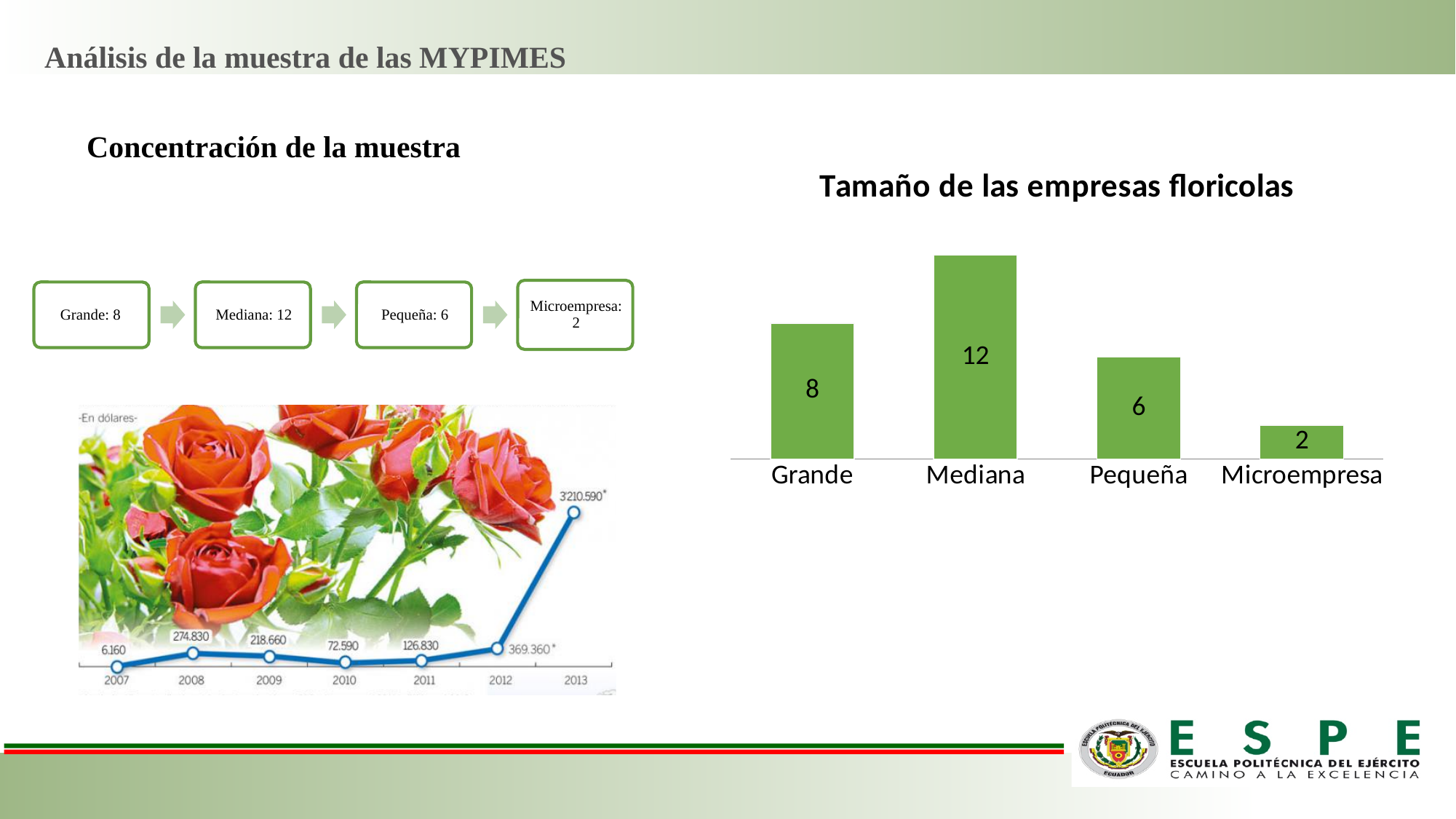
In the bar chart 'Tamaño de las empresas floricolas', what is the value for Microempresa? 2 In the line chart on the left of the slide, what is the value for 2007? 6.160 In the line chart on the left of the slide, which year has the highest value? 2013 In the bar chart 'Tamaño de las empresas floricolas', what is the difference between the values for Grande and Pequeña? 2 In the bar chart 'Tamaño de las empresas floricolas', which category has the highest value? Mediana How many categories are shown in the bar chart 'Tamaño de las empresas floricolas'? 4 What kind of chart is 'Tamaño de las empresas floricolas'? bar chart In the bar chart 'Tamaño de las empresas floricolas', which category has the lowest value? Microempresa In the bar chart 'Tamaño de las empresas floricolas', what is the value for Mediana? 12 In the bar chart 'Tamaño de las empresas floricolas', which is larger, the value for Grande or the value for Pequeña? Grande In the line chart on the left of the slide, what is the value for 2013? 3210.590 How many years are plotted in the line chart on the left of the slide? 7